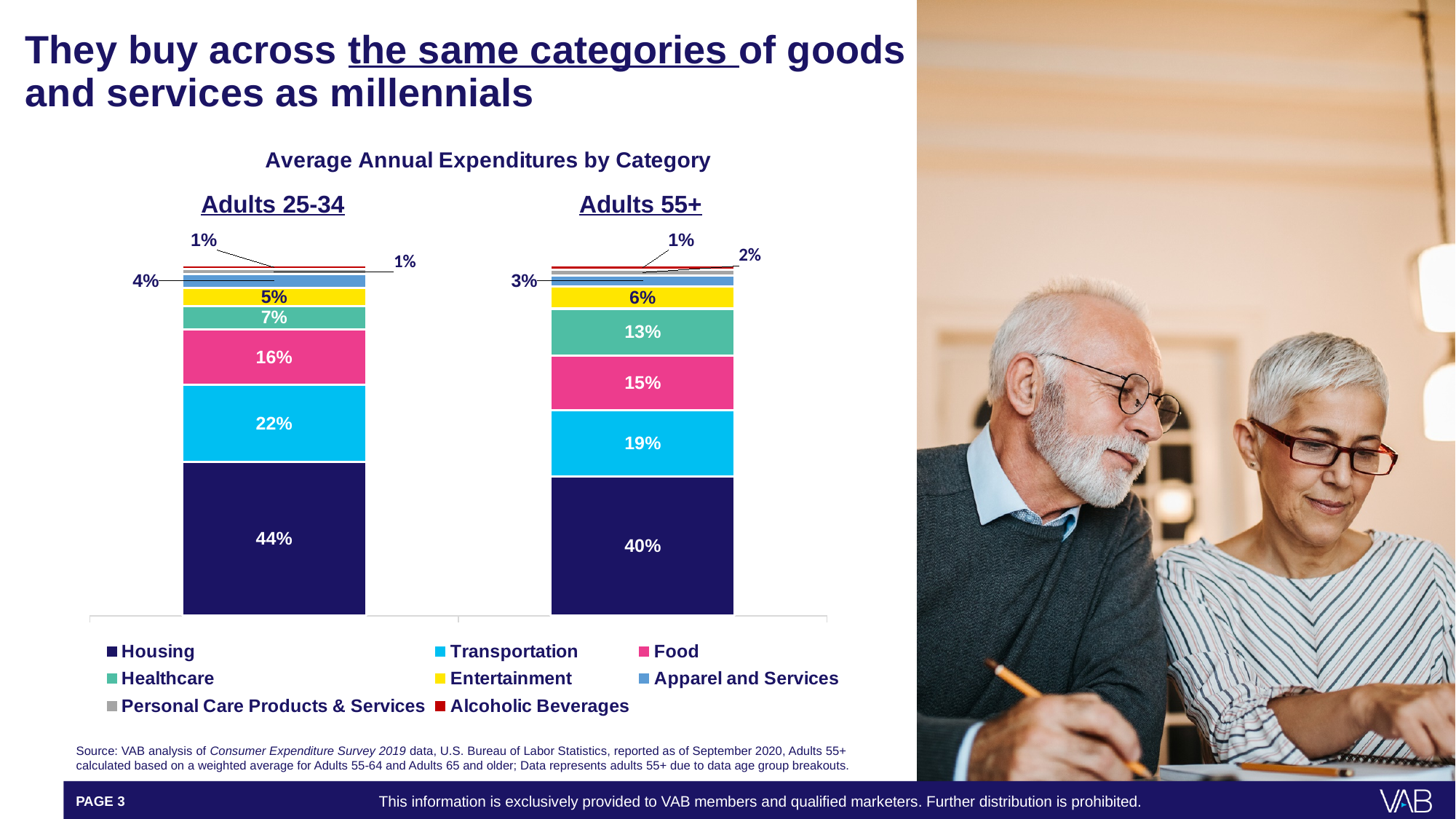
Which age group has the larger Healthcare share, Adults 25-34 or Adults 55+? Adults 55+ What is the Entertainment share for Adults 25-34? 5% Which category accounts for the largest share of expenditures for Adults 55+? Housing How many percentage points higher is the Housing share for Adults 25-34 than for Adults 55+? 4 percentage points What is the Transportation share for Adults 25-34? 22% What is the Healthcare share for Adults 55+? 13% What share of average annual expenditures goes to Housing for Adults 25-34? 44% How many expenditure categories does the legend list? 8 What is the Food share for Adults 55+? 15% How many age groups are shown as bars in the chart? 2 What share of average annual expenditures goes to Housing for Adults 55+? 40% What type of chart is used to show the expenditures by category? Stacked bar chart